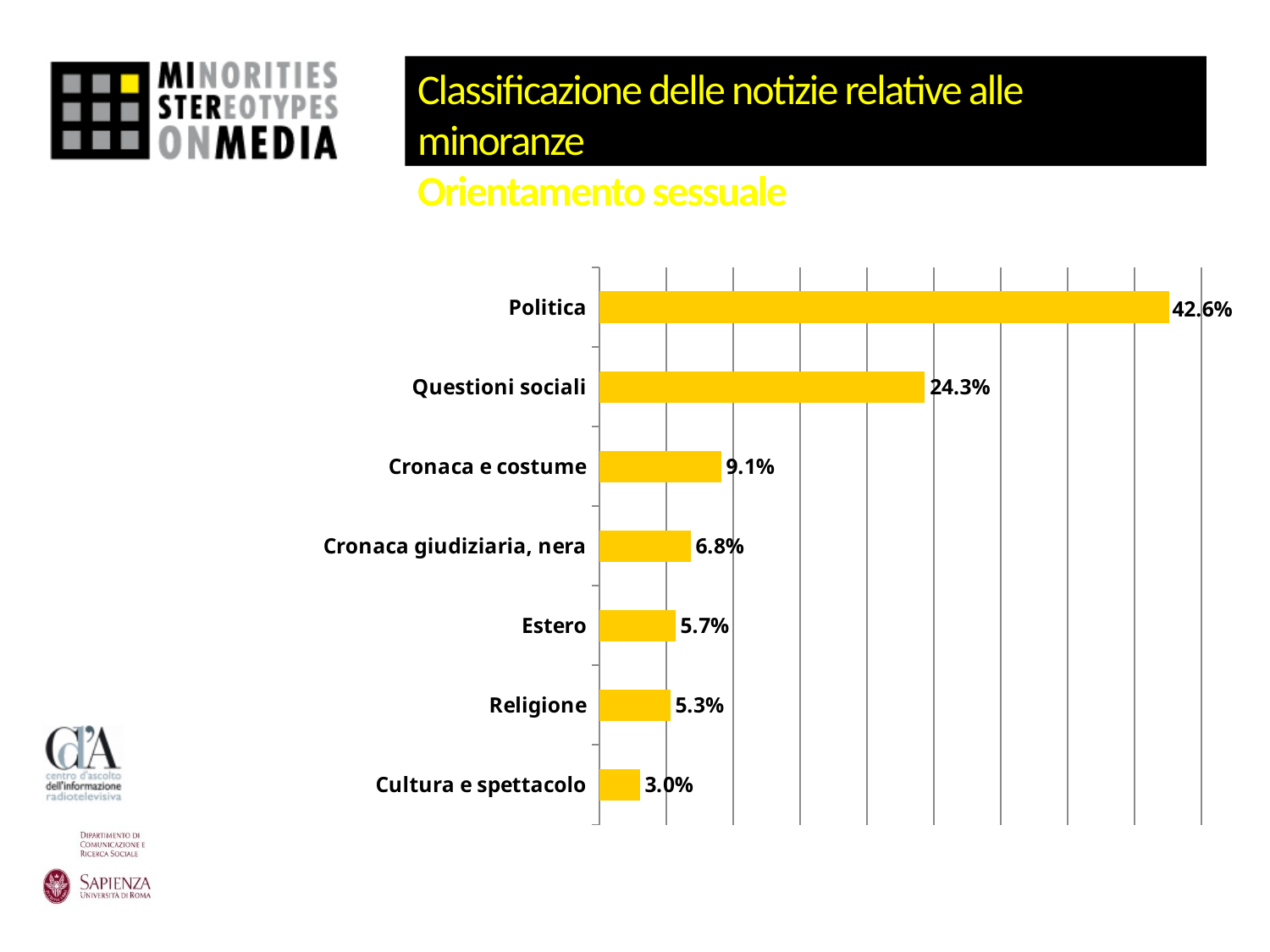
What is the value for Questioni sociali? 24.3% What is the value for Religione? 5.3% Which is larger, the value for Estero or the value for Religione? Estero What is the value for Politica? 42.6% How many categories are shown in the chart? 7 Which category has the lowest value? Cultura e spettacolo Which category has the highest value? Politica What is the subtitle shown in yellow above the chart? Orientamento sessuale What is the difference between the values for Cronaca e costume and Estero? 3.4% What is the difference between the values for Politica and Questioni sociali? 18.3% What is the value for Cronaca giudiziaria, nera? 6.8% What kind of chart is shown on the slide? Bar chart